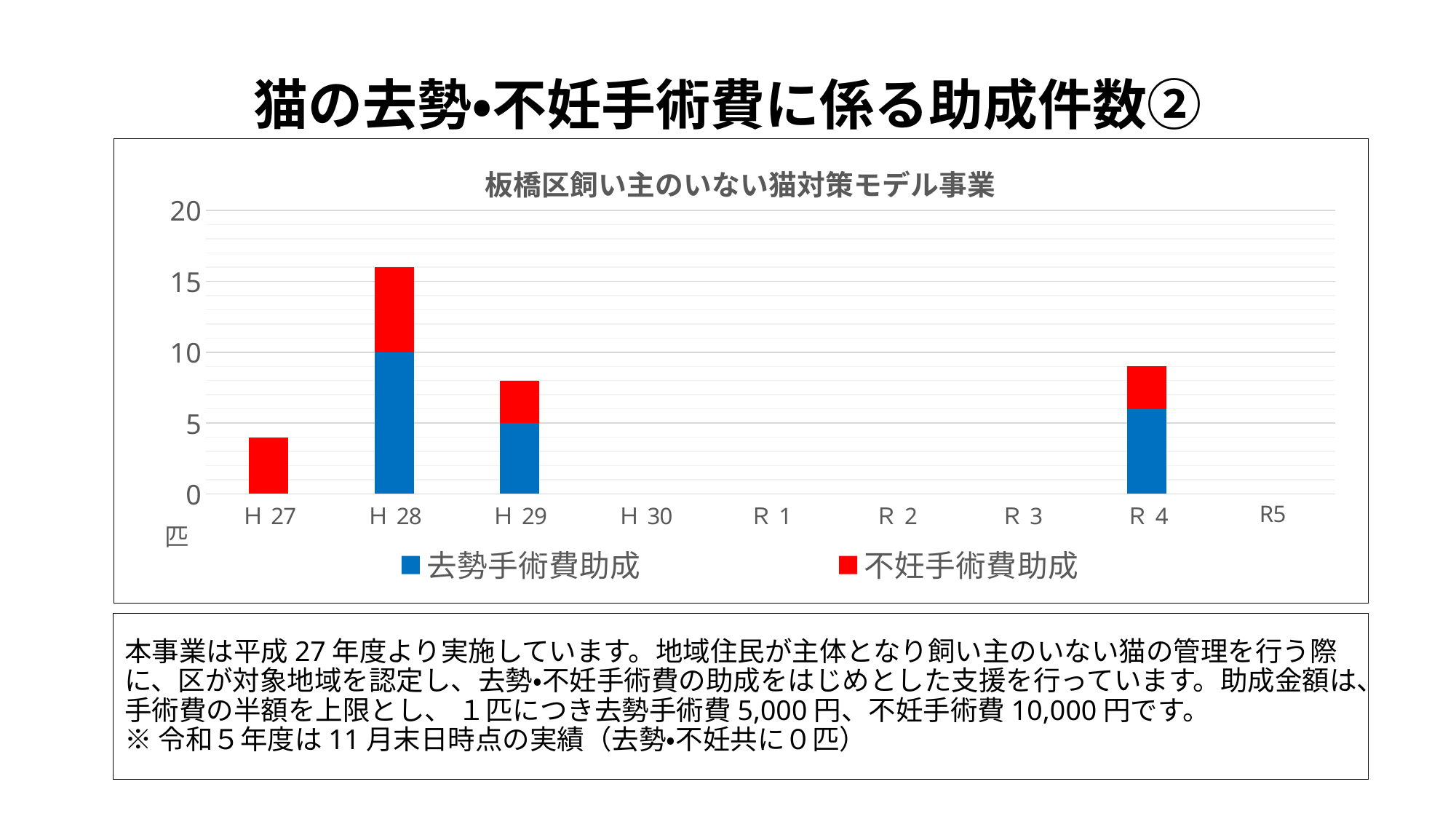
How many categories are shown on the x axis? 9 Is the total stacked value for R 4 greater or less than 10? less Which has the larger total stacked bar, H 28 or R 4? H 28 What is the value of 去勢手術費助成 for H 28? 10 Is the total stacked value for H 28 greater or less than 15? greater What is the value of 去勢手術費助成 for H 29? 5 Is the value for H 27 greater or less than 5? less How many series does the legend list? 2 What is the title of the chart? 板橋区飼い主のいない猫対策モデル事業 How many categories on the x axis have no bar at all? 5 What kind of chart is shown on the slide? bar chart Which category has the tallest stacked bar? H 28